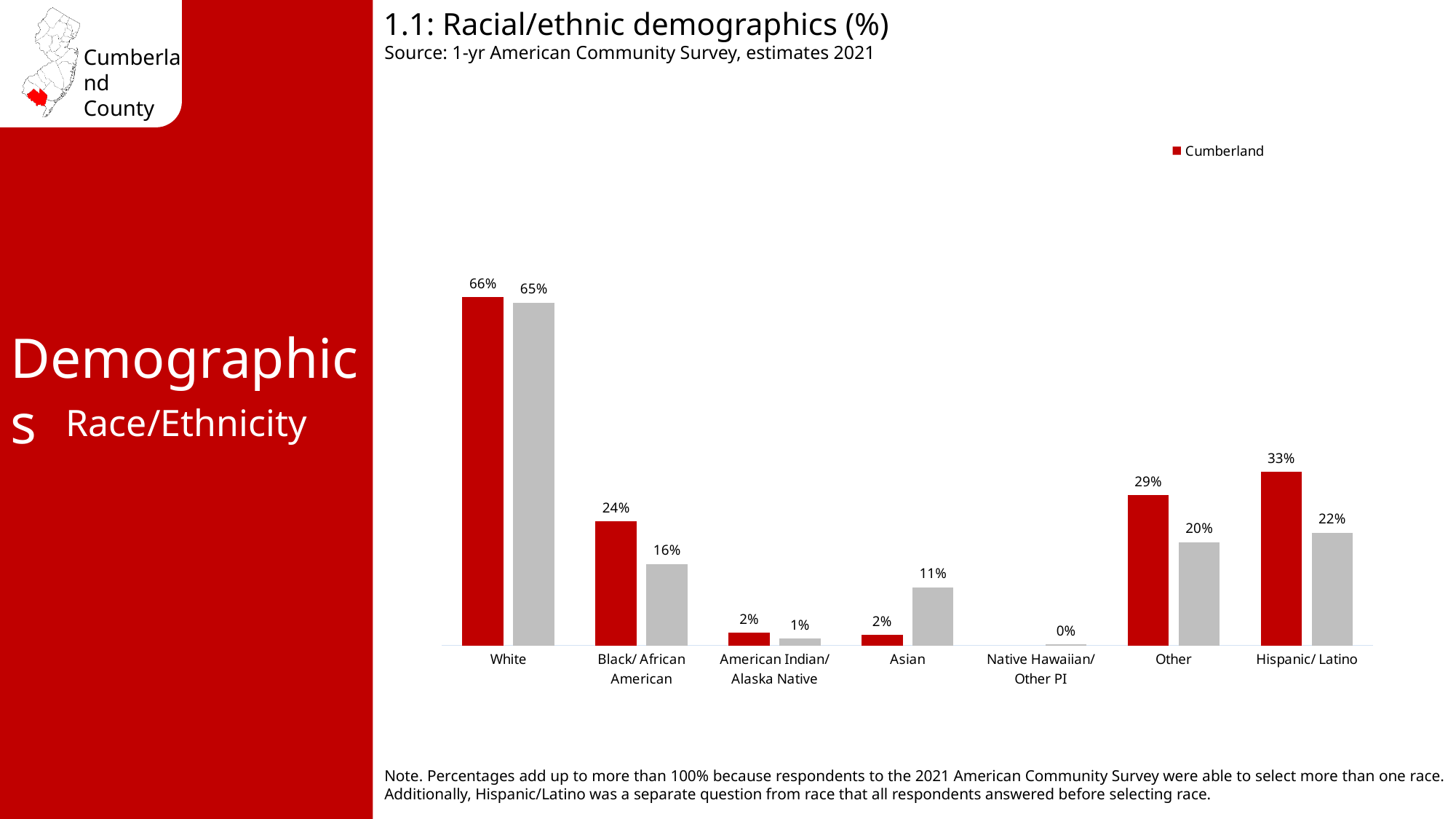
What is the Cumberland value for Other? 29% What is the Cumberland value for Hispanic/ Latino? 33% Which category has the highest Cumberland value? White What kind of chart is this? Bar chart What is the Cumberland value for Black/ African American? 24% How many categories are shown on the x axis? 7 What is the Cumberland value for White? 66% What is the difference between the Cumberland values for White and Hispanic/ Latino? 33% Which is larger for Cumberland: Other or Black/ African American? Other What is the title of the chart? 1.1: Racial/ethnic demographics (%) How many series does the legend list? 1 What is the difference between the Cumberland values for Hispanic/ Latino and Other? 4%